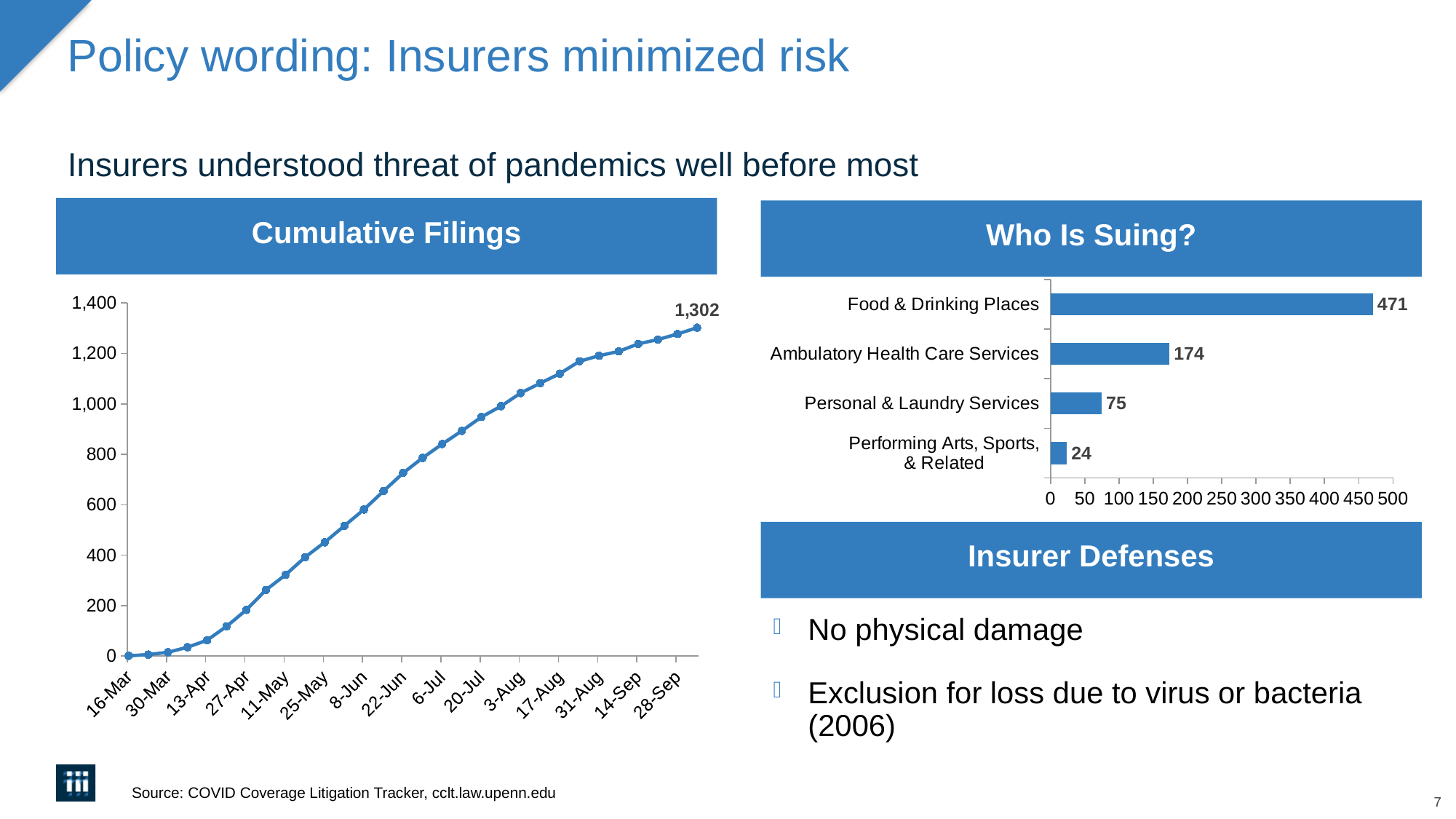
In the Cumulative Filings chart, what is the value labelled at the final data point? 1,302 In the Cumulative Filings chart, is the value at 17-Aug greater or less than 1,000? greater In the Who Is Suing? chart, which category has the highest value? Food & Drinking Places In the Cumulative Filings chart, do the values rise or fall from 16-Mar to 28-Sep? rise In the Who Is Suing? chart, which category has the lowest value? Performing Arts, Sports, & Related How many categories are shown in the Who Is Suing? chart? 4 In the Who Is Suing? chart, what is the value for Ambulatory Health Care Services? 174 In the Cumulative Filings chart, is the value at 11-May greater or less than 400? less In the Who Is Suing? chart, what is the value for Food & Drinking Places? 471 What kind of chart is the Who Is Suing? chart? bar chart What kind of chart is the Cumulative Filings chart? line chart In the Who Is Suing? chart, what is the difference between Food & Drinking Places and Ambulatory Health Care Services? 297